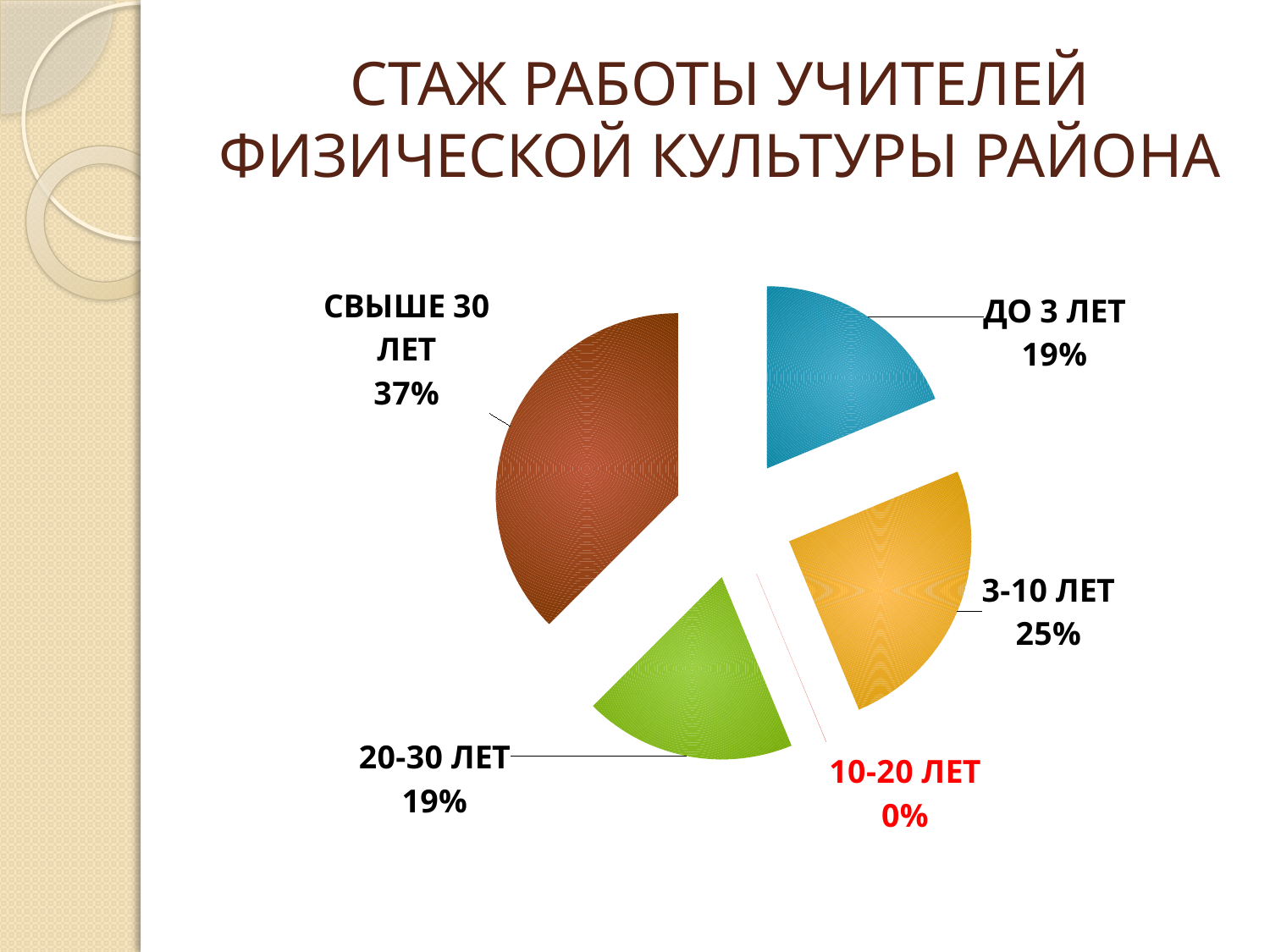
What share of the pie is labelled 20-30 ЛЕТ? 19% What is the title of the chart on the slide? СТАЖ РАБОТЫ УЧИТЕЛЕЙ ФИЗИЧЕСКОЙ КУЛЬТУРЫ РАЙОНА How many categories are labelled on the pie chart? 5 What is the difference between the shares for СВЫШЕ 30 ЛЕТ and 3-10 ЛЕТ? 12% What kind of chart is shown on the slide? pie chart What share of the pie is labelled ДО 3 ЛЕТ? 19% Which is larger, the share for 3-10 ЛЕТ or the share for 20-30 ЛЕТ? 3-10 ЛЕТ Which category has the smallest share of the pie? 10-20 ЛЕТ What share of the pie is labelled 3-10 ЛЕТ? 25% Which category has the largest share of the pie? СВЫШЕ 30 ЛЕТ